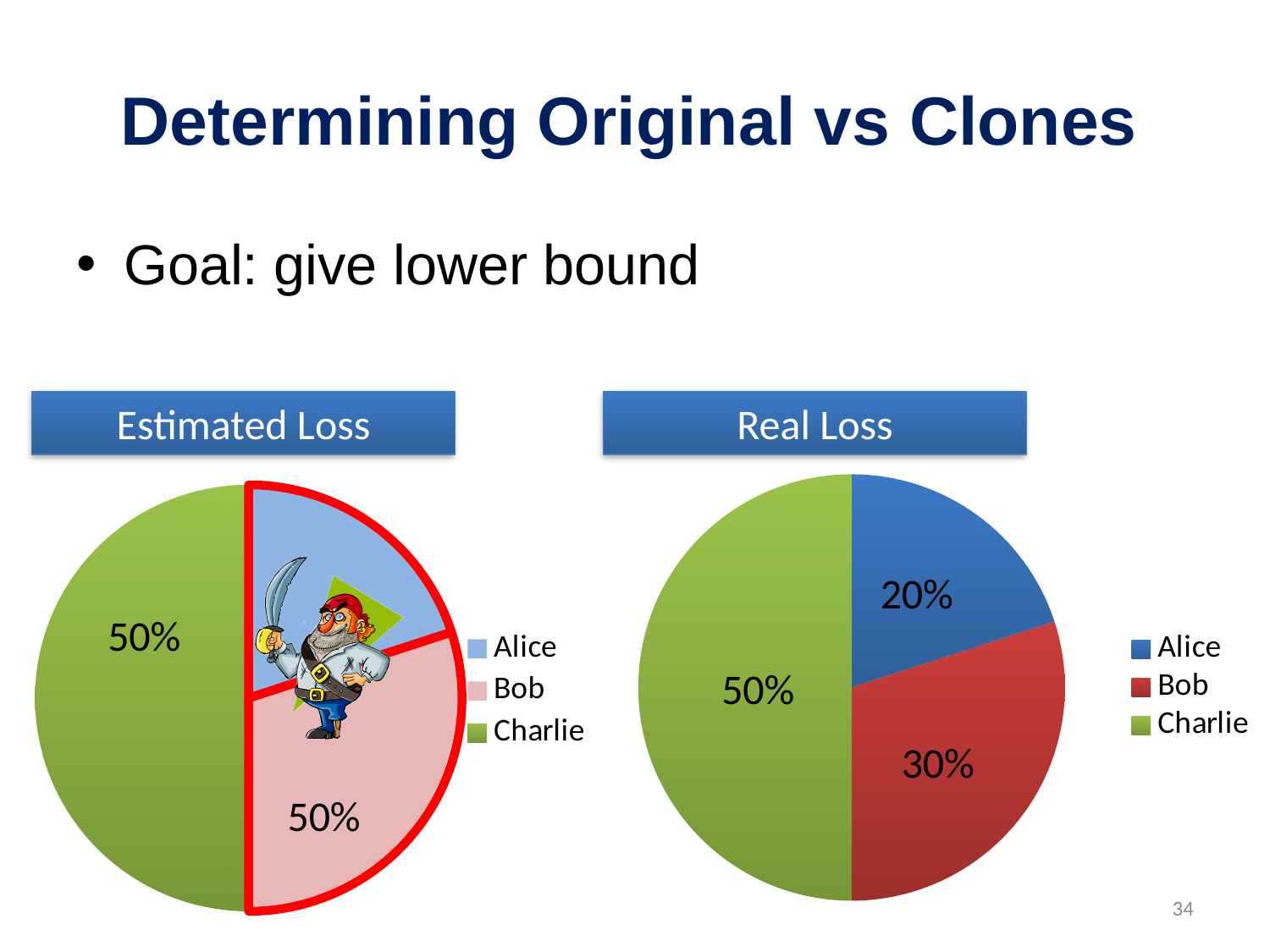
In the Real Loss chart, what is the difference between Charlie's share and Alice's share? 30% In the Real Loss chart, what share of the pie does Bob have? 30% In the Real Loss chart, which category has the smallest slice? Alice In the Real Loss chart, which is larger, Bob's slice or Alice's slice? Bob How many categories does the legend of the Real Loss chart list? 3 In the Real Loss chart, what share of the pie does Charlie have? 50% In the Real Loss chart, which category has the largest slice? Charlie In the Estimated Loss chart, which is larger, Charlie's slice or Alice's slice? Charlie What kind of chart is the Real Loss chart? Pie chart What is the title of the chart on the left side of the slide? Estimated Loss In the Real Loss chart, what share of the pie does Alice have? 20% In the Estimated Loss chart, what share of the pie does Charlie have? 50%